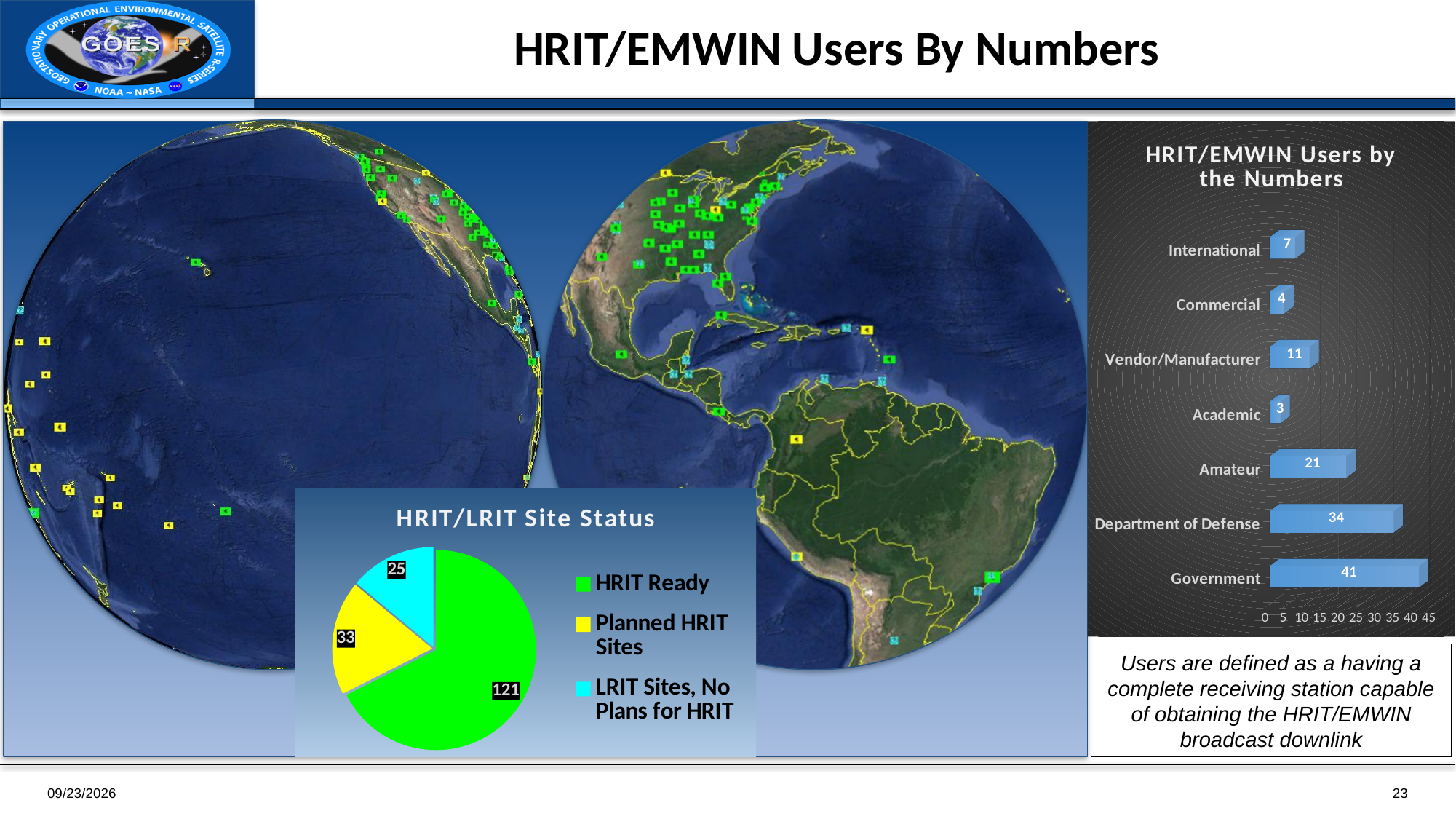
In the HRIT/LRIT Site Status pie chart, what is the value for Planned HRIT Sites? 33 In the HRIT/EMWIN Users by the Numbers chart, what is the difference between Department of Defense and Amateur? 13 In the HRIT/EMWIN Users by the Numbers chart, which category has the lowest value? Academic How many categories are shown in the HRIT/EMWIN Users by the Numbers chart? 7 In the HRIT/EMWIN Users by the Numbers chart, what is the value for Vendor/Manufacturer? 11 What kind of chart is the HRIT/EMWIN Users by the Numbers chart? Bar chart How many entries does the legend of the HRIT/LRIT Site Status pie chart list? 3 In the HRIT/EMWIN Users by the Numbers chart, which category has the highest value? Government In the HRIT/LRIT Site Status pie chart, which category has the largest slice? HRIT Ready In the HRIT/LRIT Site Status pie chart, what is the difference between HRIT Ready and LRIT Sites, No Plans for HRIT? 96 In the HRIT/EMWIN Users by the Numbers chart, what is the value for Government? 41 In the HRIT/EMWIN Users by the Numbers chart, which is larger, International or Commercial? International